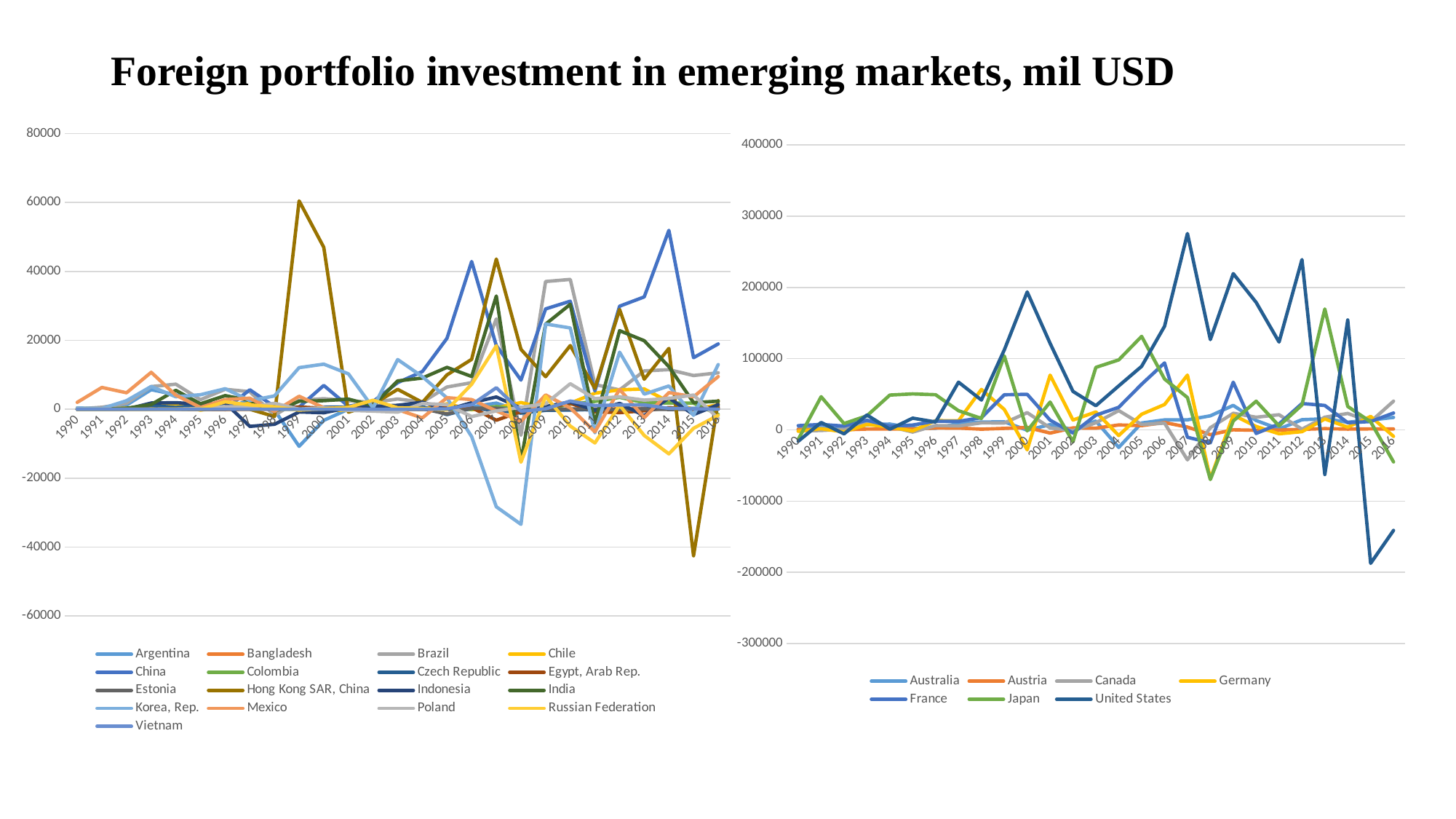
In the left-hand chart, is the value for Hong Kong SAR, China in 1999 greater or less than 40000? greater What is the title of the slide? Foreign portfolio investment in emerging markets, mil USD How many years are shown along the x axis of the right-hand chart? 27 In the left-hand chart, is the value for Hong Kong SAR, China in 2015 greater or less than -20000? less In the right-hand chart, is the value for United States in 2007 greater or less than 200000? greater In the right-hand chart, which series reaches the highest value shown? United States What kind of chart is the chart on the right side of the slide? line chart How many series does the legend of the left-hand chart list? 17 What kind of chart is the chart on the left side of the slide? line chart How many series does the legend of the right-hand chart list? 7